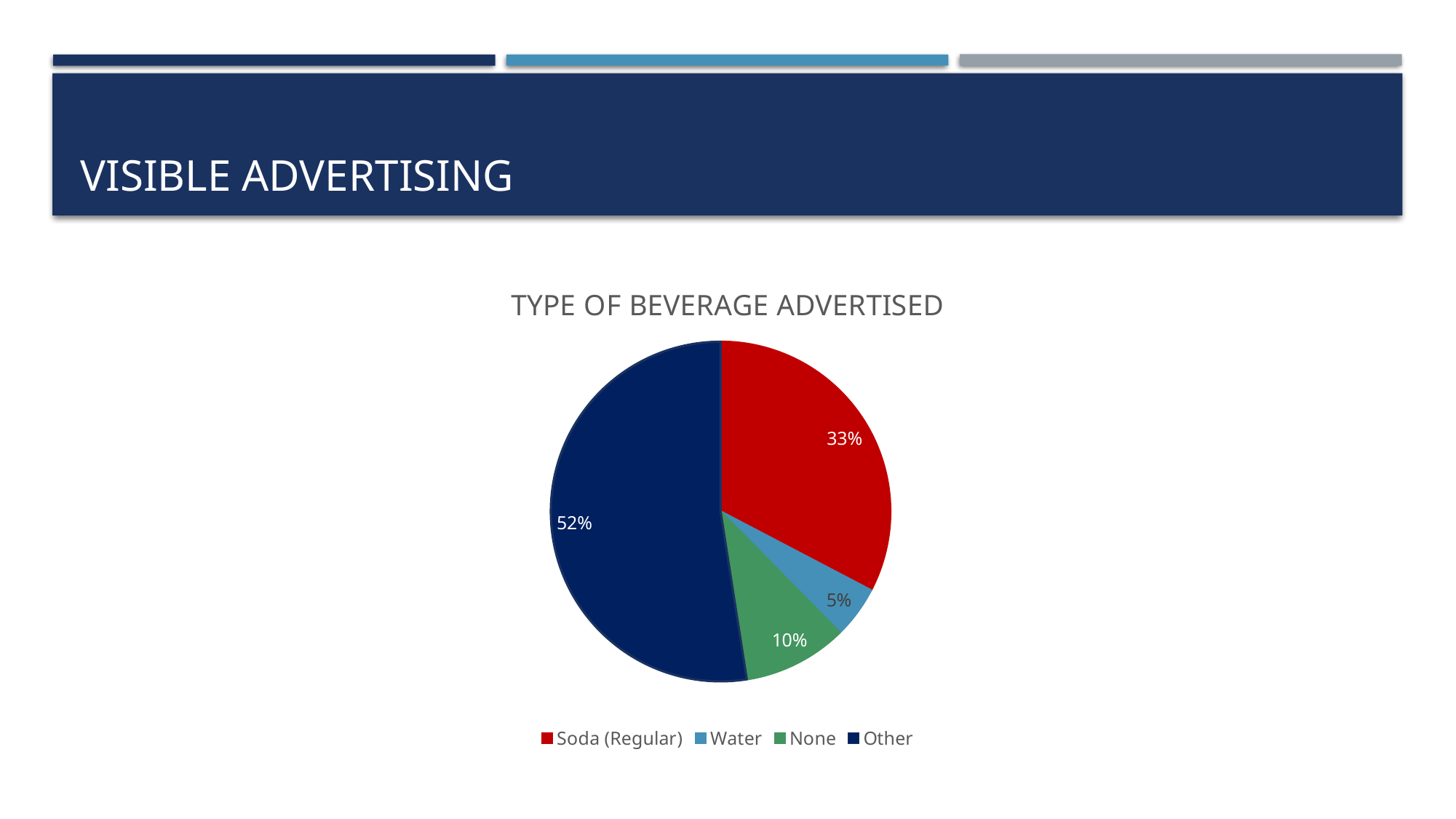
Which category has the largest slice of the pie? Other Which category has the smallest slice of the pie? Water What share of the pie is Water? 5% Which is larger, the share for None or the share for Water? None What share of the pie is Soda (Regular)? 33% What type of chart is shown on the slide? pie chart What share of the pie is None? 10% What colour is the Soda (Regular) slice? red What is the difference between the Other share and the Soda (Regular) share? 19% How many slices does the pie chart have? 4 What is the title of the chart? TYPE OF BEVERAGE ADVERTISED